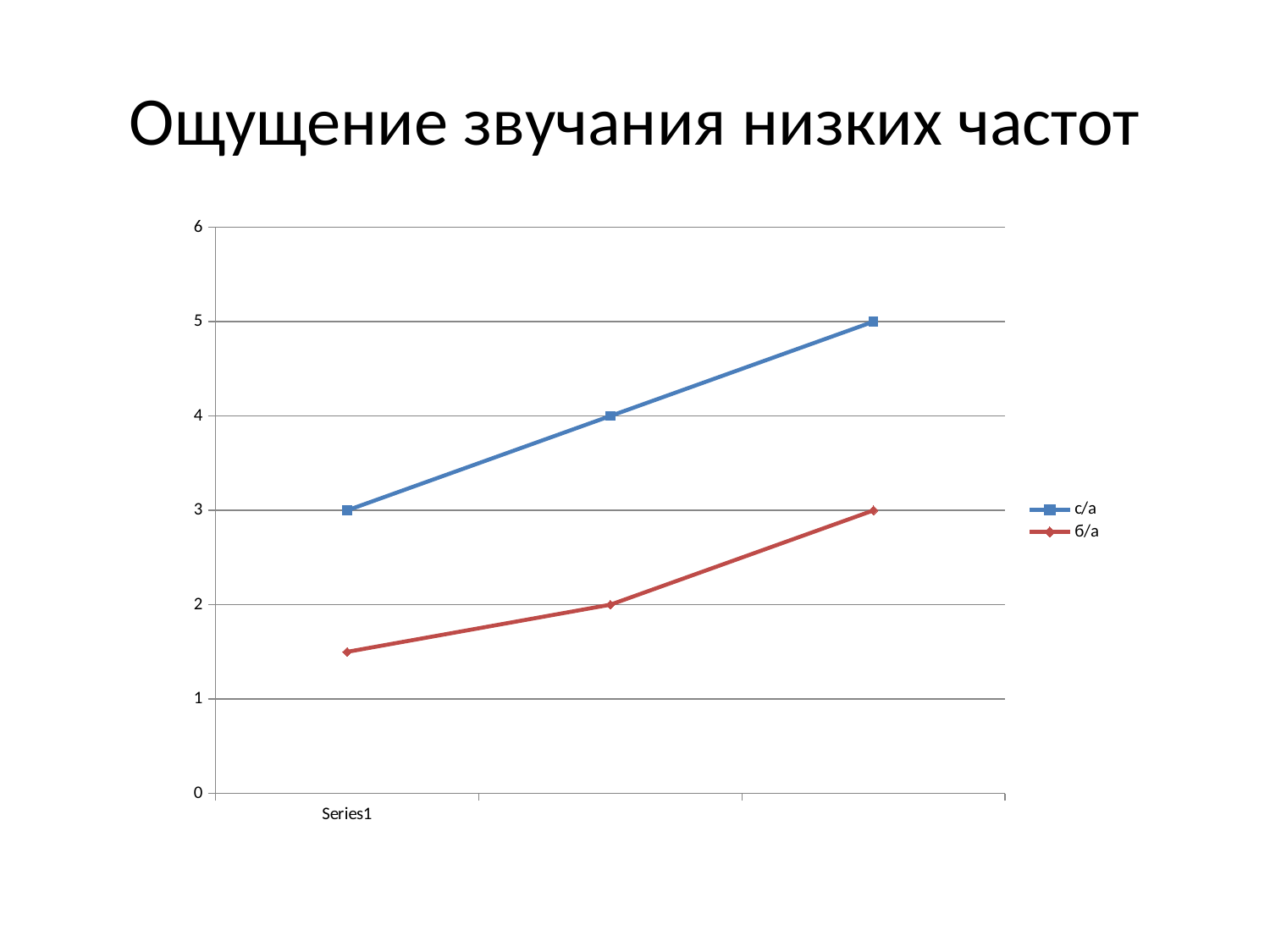
What is the value of с/а at Series1? 3 Is the value for б/а at Series1 greater or less than 2? less What is the title of the slide? Ощущение звучания низких частот Do the values of с/а rise or fall along the x axis? rise Do the values of б/а rise or fall along the x axis? rise What is the highest value reached by the б/а line? 3 What is the highest value reached by the с/а line? 5 How many series does the legend list? 2 What kind of chart is shown on the slide? line chart At Series1, which series has the higher value, с/а or б/а? с/а How many data points does each line have? 3 What is the difference between the highest value of с/а and the highest value of б/а? 2